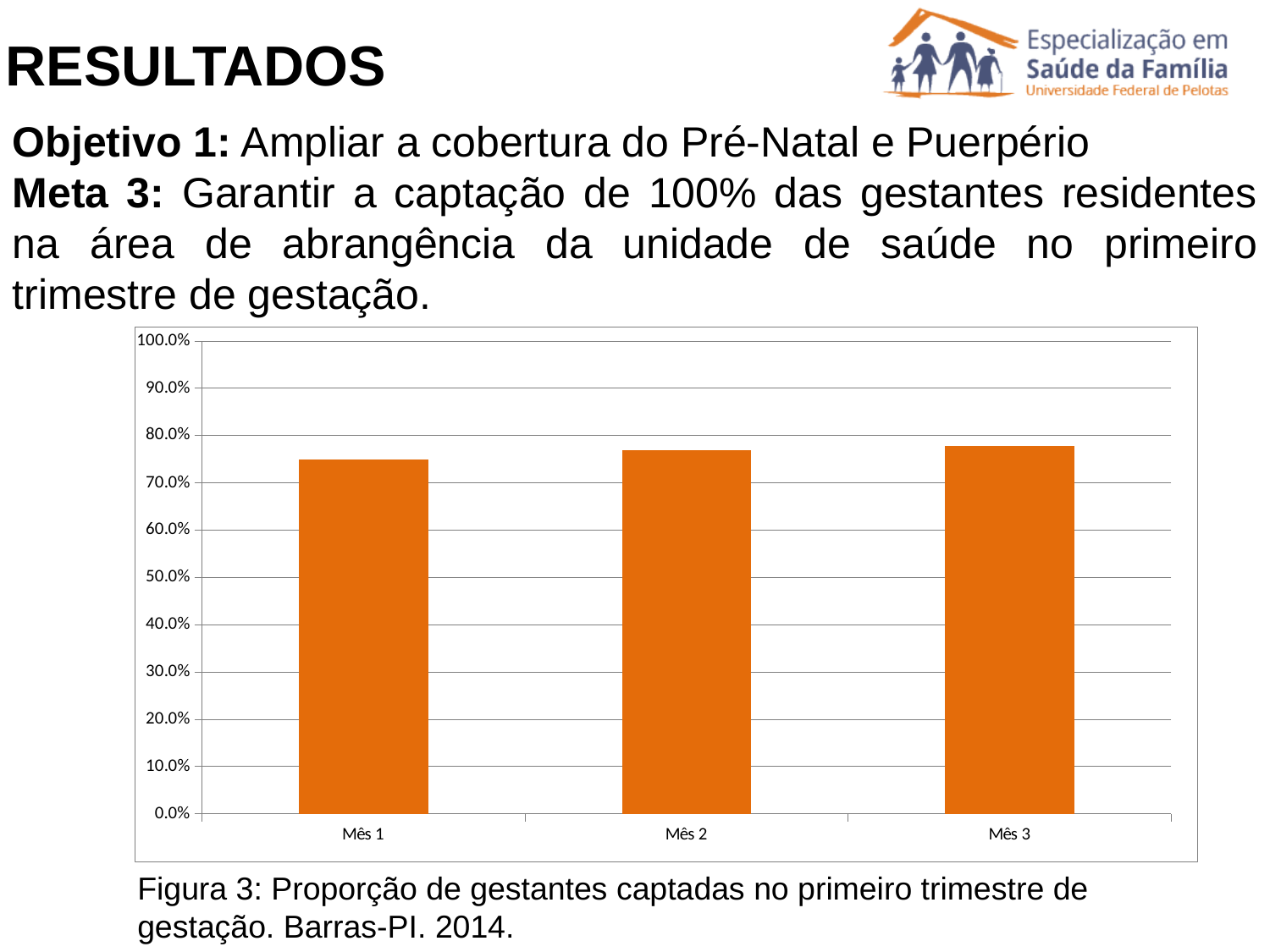
What colour are the bars in the chart? orange What is the highest value shown on the y axis of the chart? 100.0% Is the value for Mês 3 greater or less than 70.0%? greater How many categories are shown on the x axis of the chart? 3 What kind of chart is shown on the slide? bar chart Is the value for Mês 2 greater or less than 80.0%? less Is the value for Mês 1 greater or less than 80.0%? less Do the values rise or fall from Mês 1 to Mês 3? rise Which is larger, the value for Mês 1 or the value for Mês 3? Mês 3